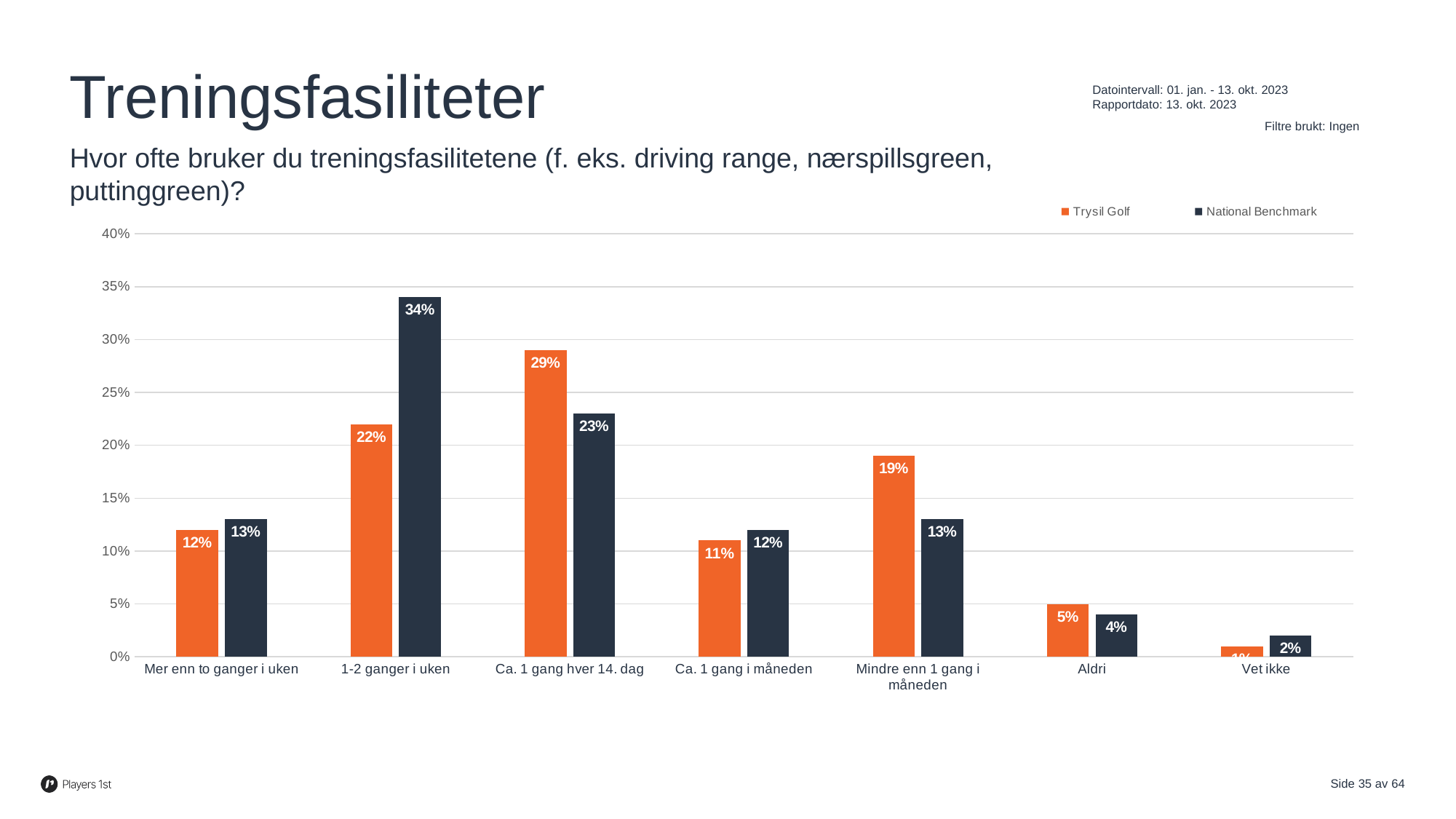
What kind of chart is shown on the slide? Bar chart Which series is shown in orange? Trysil Golf What is the National Benchmark value for "1-2 ganger i uken"? 34% What is the Trysil Golf value for "Mindre enn 1 gang i måneden"? 19% Which category has the lowest Trysil Golf value? Vet ikke What is the difference between the National Benchmark and Trysil Golf values for "1-2 ganger i uken"? 12% How many series does the legend list? 2 What is the Trysil Golf value for "Ca. 1 gang hver 14. dag"? 29% Which category has the highest National Benchmark value? 1-2 ganger i uken How many categories are shown on the x axis? 7 Which is larger for "Ca. 1 gang hver 14. dag": Trysil Golf or National Benchmark? Trysil Golf Is the National Benchmark value for "1-2 ganger i uken" greater or less than 30%? greater